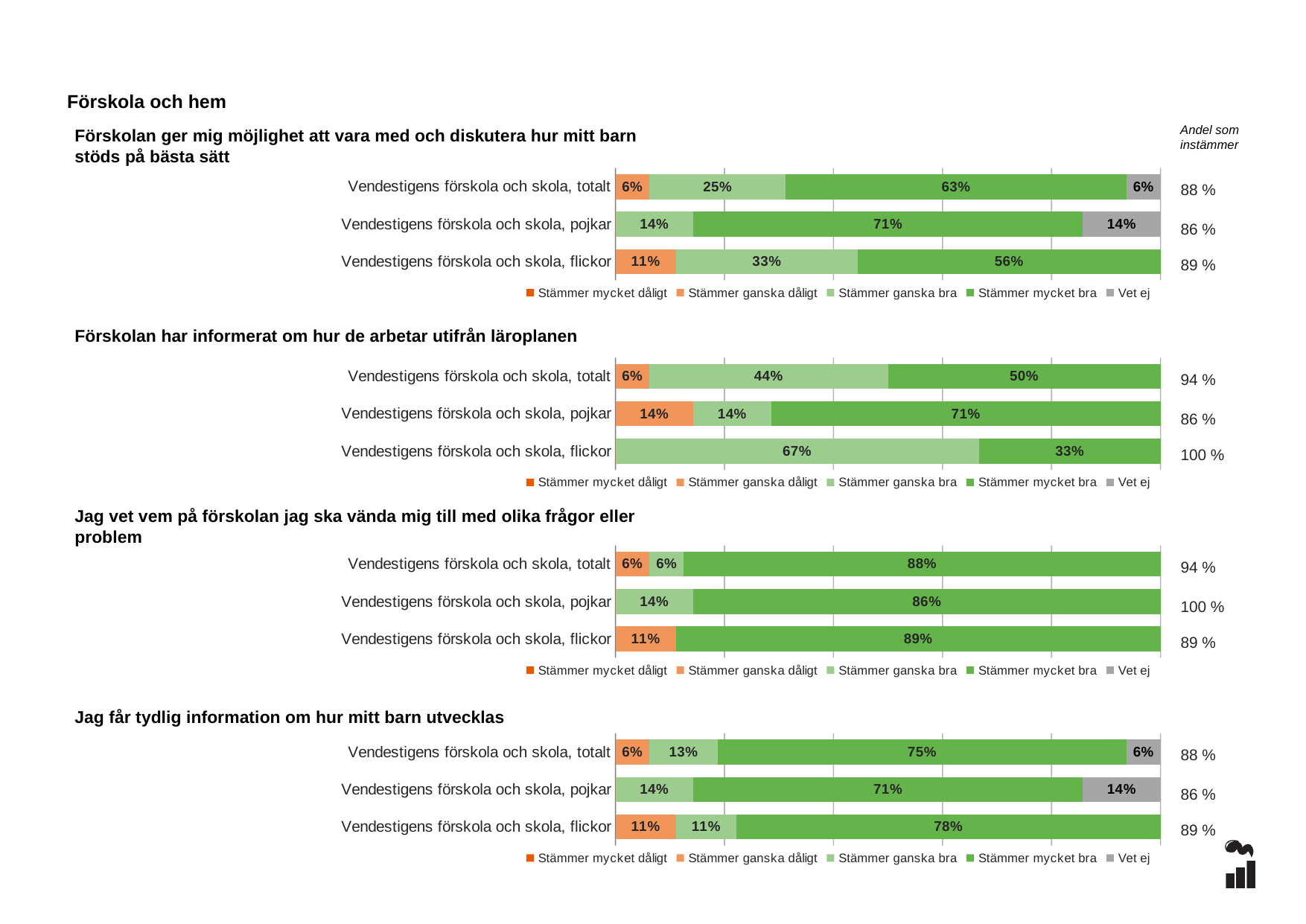
In the chart 'Jag får tydlig information om hur mitt barn utvecklas', which row has the lowest 'Stämmer mycket bra' value? Vendestigens förskola och skola, pojkar In the chart 'Jag får tydlig information om hur mitt barn utvecklas', is the 'Stämmer mycket bra' value larger for totalt or for flickor? flickor How many series does the legend list for the chart 'Förskolan har informerat om hur de arbetar utifrån läroplanen'? 5 In the chart 'Förskolan har informerat om hur de arbetar utifrån läroplanen', which row has the highest 'Stämmer mycket bra' value? Vendestigens förskola och skola, pojkar How many rows (categories) are shown in the chart 'Jag vet vem på förskolan jag ska vända mig till med olika frågor eller problem'? 3 In the chart 'Jag vet vem på förskolan jag ska vända mig till med olika frågor eller problem', what is the 'Stämmer mycket bra' value for Vendestigens förskola och skola, totalt? 88% In the chart 'Förskolan har informerat om hur de arbetar utifrån läroplanen', what is the 'Stämmer ganska bra' value for Vendestigens förskola och skola, flickor? 67% In the chart 'Förskolan ger mig möjlighet att vara med och diskutera hur mitt barn stöds på bästa sätt', what is the 'Stämmer mycket bra' value for Vendestigens förskola och skola, pojkar? 71% In the chart 'Jag vet vem på förskolan jag ska vända mig till med olika frågor eller problem', what is the difference between the 'Stämmer mycket bra' values for flickor and pojkar? 3% What kind of chart is 'Förskolan ger mig möjlighet att vara med och diskutera hur mitt barn stöds på bästa sätt'? Stacked bar chart In the chart 'Jag får tydlig information om hur mitt barn utvecklas', what is the 'Stämmer mycket bra' value for Vendestigens förskola och skola, flickor? 78% In the chart 'Förskolan ger mig möjlighet att vara med och diskutera hur mitt barn stöds på bästa sätt', what is the 'Stämmer ganska bra' value for Vendestigens förskola och skola, flickor? 33%